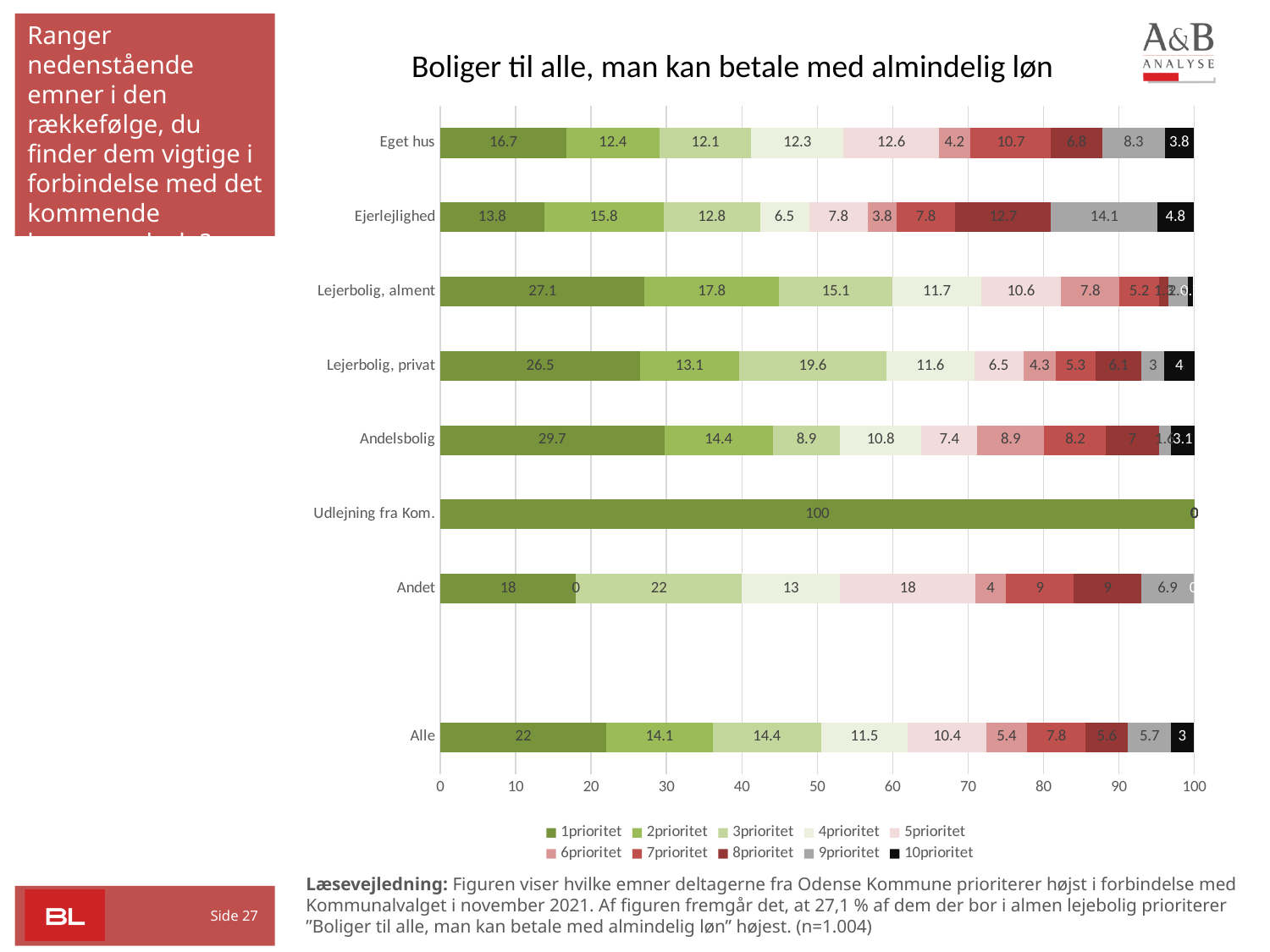
Which category has the lowest 1prioritet value? Ejerlejlighed What is the difference between the 1prioritet values for Andelsbolig and Eget hus? 13 What is the 1prioritet value for Alle? 22 What is the title of the chart? Boliger til alle, man kan betale med almindelig løn How many series does the legend list? 10 What is the 1prioritet value for Lejerbolig, alment? 27.1 How many categories are shown on the vertical axis of the chart? 8 Which category has the highest 1prioritet value? Udlejning fra Kom. What is the 3prioritet value for Lejerbolig, privat? 19.6 Which has a larger 9prioritet value, Ejerlejlighed or Eget hus? Ejerlejlighed What type of chart is shown on the slide? Stacked bar chart What is the 2prioritet value for Ejerlejlighed? 15.8